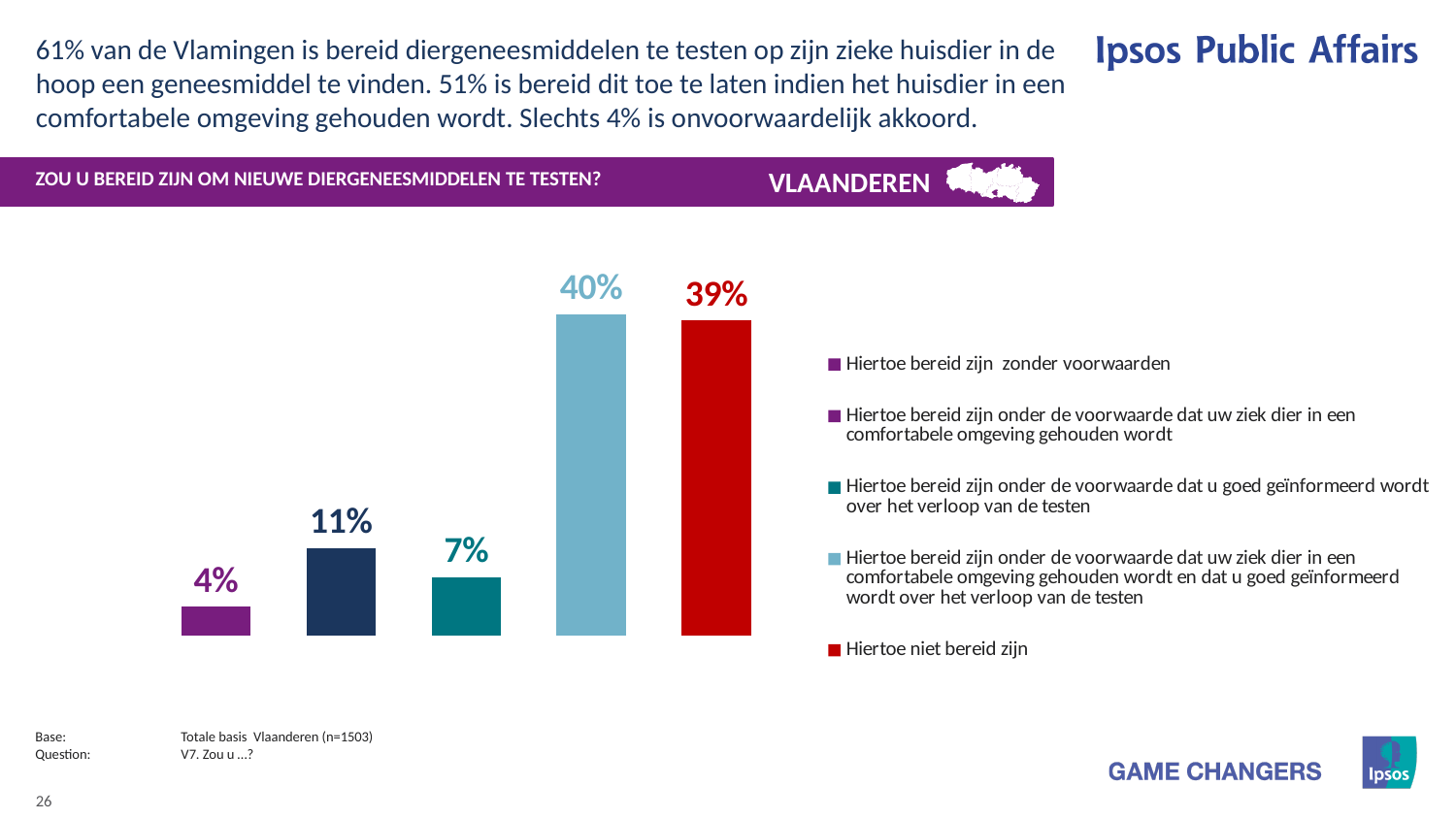
What percentage is shown for the option where the sick animal is kept in a comfortable environment and the owner is well informed about the course of the tests? 40% Which is larger: the value for the 'comfortabele omgeving' condition alone (11%) or the 'goed geïnformeerd' condition alone (7%)? Hiertoe bereid zijn onder de voorwaarde dat uw ziek dier in een comfortabele omgeving gehouden wordt What kind of chart is shown on the slide? bar chart What is the difference between the value for 'Hiertoe niet bereid zijn' and the value for 'Hiertoe bereid zijn zonder voorwaarden'? 35% What percentage is shown for 'Hiertoe niet bereid zijn'? 39% What percentage is shown for 'Hiertoe bereid zijn onder de voorwaarde dat uw ziek dier in een comfortabele omgeving gehouden wordt'? 11% How many bars are plotted in the chart? 5 Which legend entry has the highest value in the chart? Hiertoe bereid zijn onder de voorwaarde dat uw ziek dier in een comfortabele omgeving gehouden wordt en dat u goed geïnformeerd wordt over het verloop van de testen What percentage is shown for 'Hiertoe bereid zijn onder de voorwaarde dat u goed geïnformeerd wordt over het verloop van de testen'? 7% Which legend entry has the lowest value in the chart? Hiertoe bereid zijn zonder voorwaarden What colour is the bar for 'Hiertoe niet bereid zijn'? red What percentage is shown for 'Hiertoe bereid zijn zonder voorwaarden'? 4%